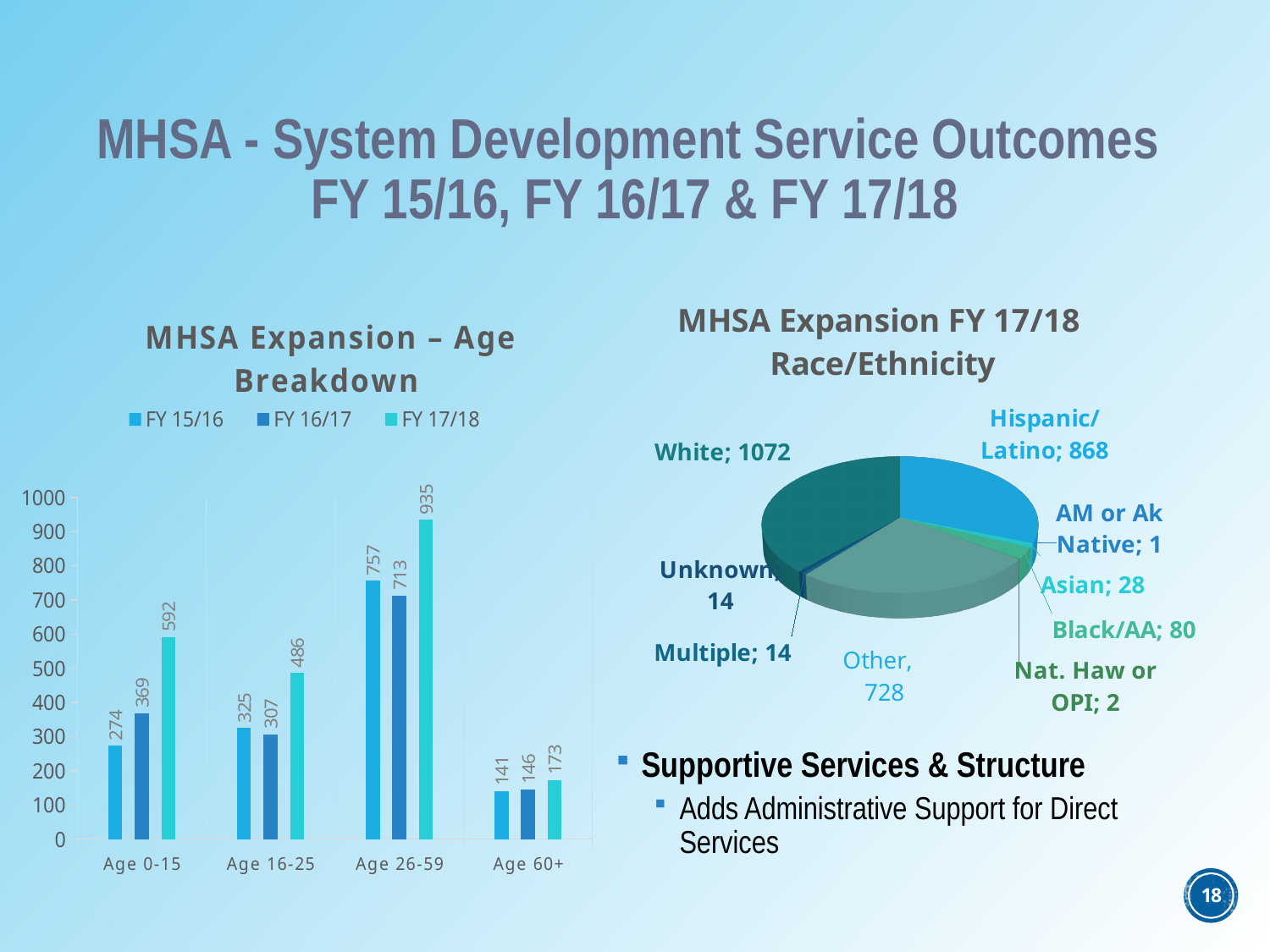
In the MHSA Expansion – Age Breakdown chart, which is larger for Age 16-25: FY 15/16 or FY 16/17? FY 15/16 What kind of chart is the MHSA Expansion – Age Breakdown chart? Bar chart How many age groups are shown in the MHSA Expansion – Age Breakdown chart? 4 How many series does the legend of the MHSA Expansion – Age Breakdown chart list? 3 In the MHSA Expansion – Age Breakdown chart, which age group has the lowest FY 15/16 value? Age 60+ What kind of chart is the MHSA Expansion FY 17/18 Race/Ethnicity chart? Pie chart In the MHSA Expansion FY 17/18 Race/Ethnicity chart, which category has the largest value? White In the MHSA Expansion FY 17/18 Race/Ethnicity chart, what is the value for Hispanic/Latino? 868 In the MHSA Expansion – Age Breakdown chart, which age group has the highest FY 17/18 value? Age 26-59 In the MHSA Expansion – Age Breakdown chart, what is the FY 15/16 value for Age 16-25? 325 In the MHSA Expansion – Age Breakdown chart, what is the difference between the FY 17/18 and FY 16/17 values for Age 0-15? 223 In the MHSA Expansion – Age Breakdown chart, what is the FY 17/18 value for Age 26-59? 935